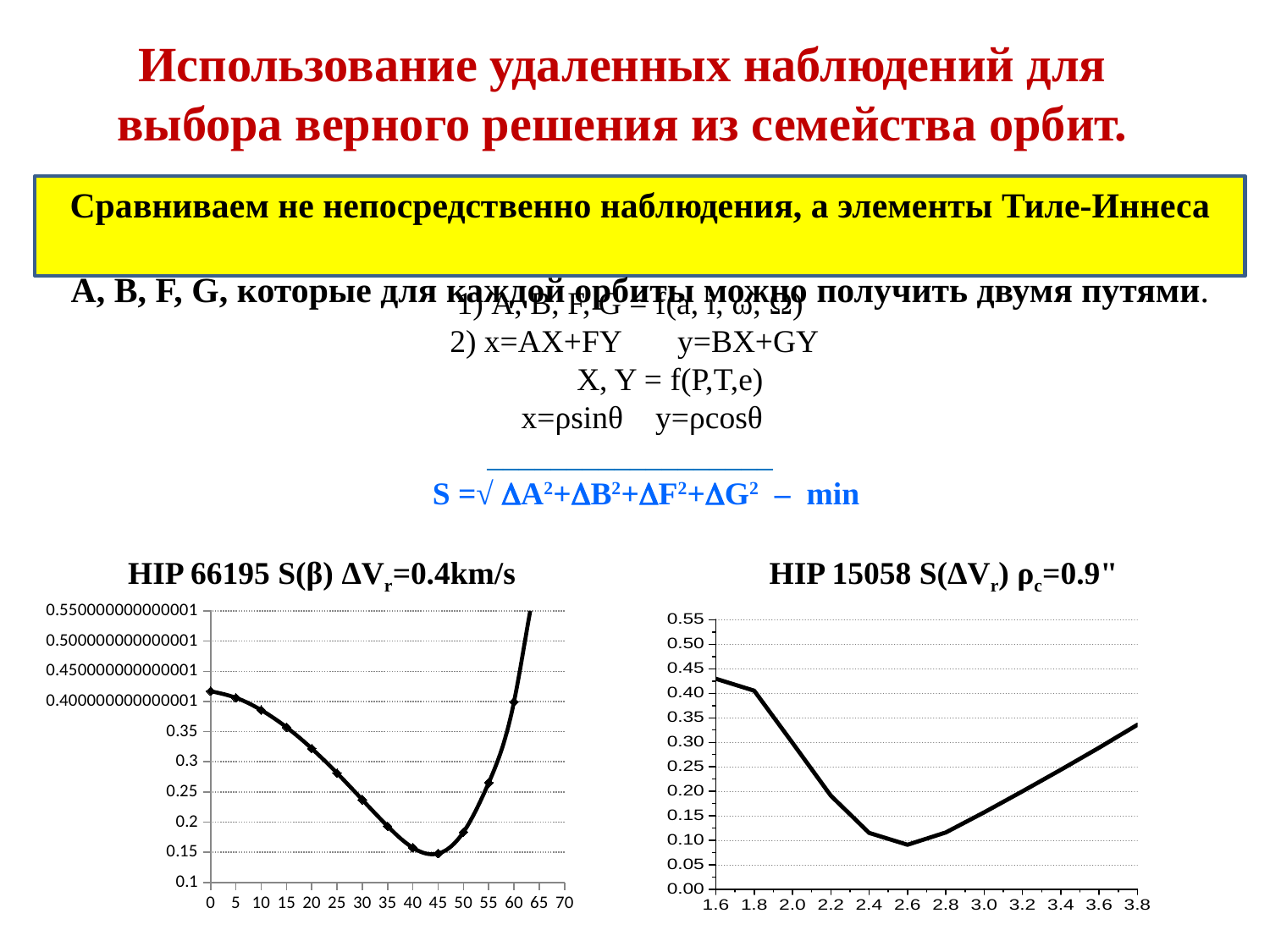
In the right chart (HIP 15058), is the value at x=1.6 greater or less than 0.40? greater In the right chart (HIP 15058), is the value at x=3.8 greater or less than 0.30? greater In the right chart (HIP 15058), do the values rise or fall as x goes from 1.6 to 2.6? fall In the left chart (HIP 66195), at which x-axis value does the curve reach its lowest point? 45 What kind of chart is the right chart titled HIP 15058 S(ΔVr) ρc=0.9"? line chart In the right chart (HIP 15058), at which x-axis value does the curve reach its lowest point? 2.6 In the left chart (HIP 66195), is the value at x=30 greater or less than 0.3? less How many x-axis tick labels does the right chart (HIP 15058) show? 12 What kind of chart is the left chart titled HIP 66195 S(β) ΔVr=0.4km/s? line chart In the left chart (HIP 66195), which is larger: the value at x=0 or the value at x=45? x=0